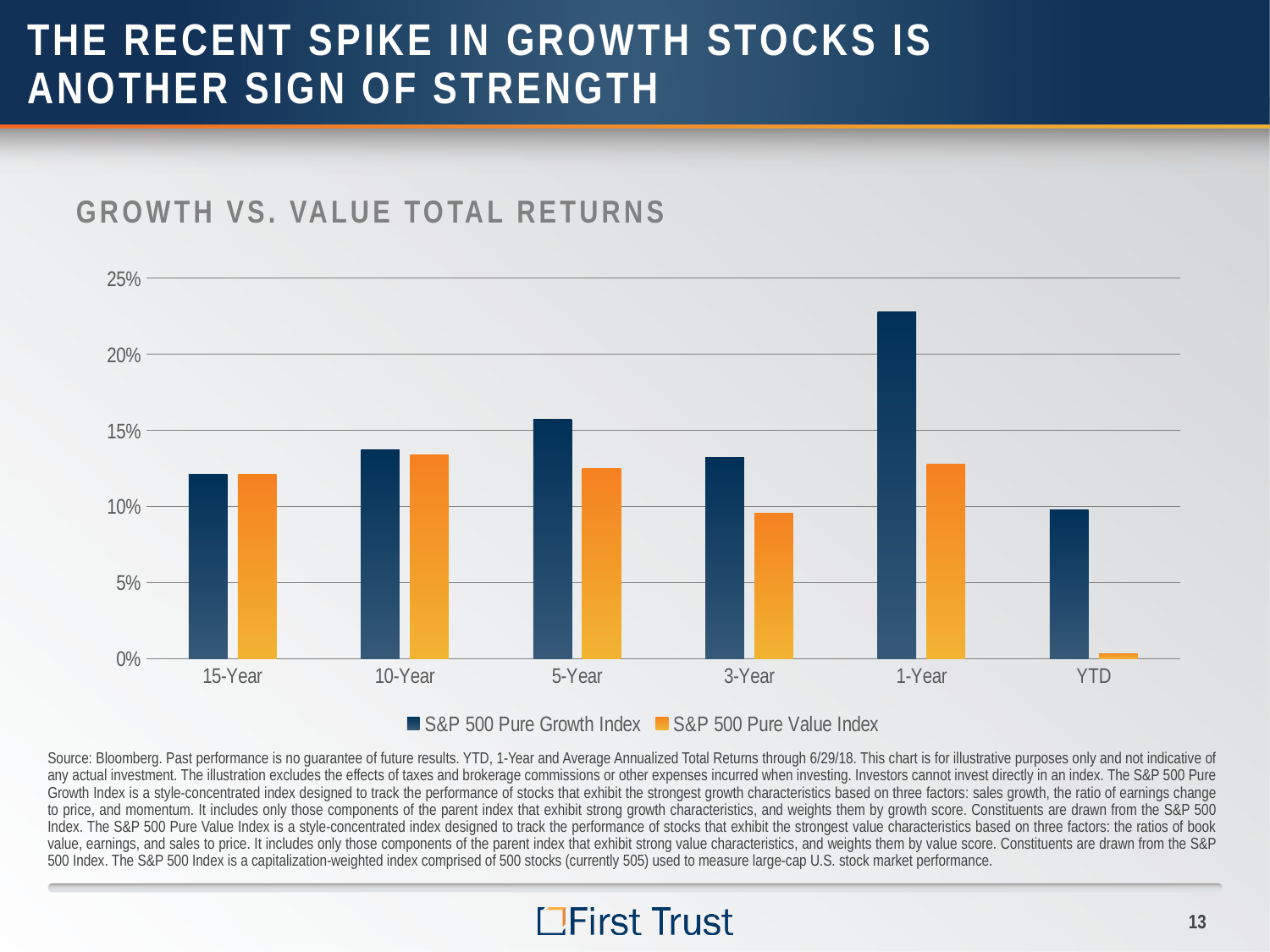
Which period has the lowest value for the S&P 500 Pure Growth Index? YTD What is the title of the chart? GROWTH VS. VALUE TOTAL RETURNS Which period has the highest value for the S&P 500 Pure Growth Index? 1-Year How many time-period categories are shown on the x axis? 6 How many series does the legend list? 2 Is the 1-Year value for the S&P 500 Pure Growth Index greater or less than 20%? greater Is the 3-Year value for the S&P 500 Pure Value Index greater or less than 10%? less Which period has the lowest value for the S&P 500 Pure Value Index? YTD For the 1-Year period, which is larger: the S&P 500 Pure Growth Index or the S&P 500 Pure Value Index? S&P 500 Pure Growth Index What type of chart is shown on the slide? bar chart Is the 5-Year value for the S&P 500 Pure Growth Index greater or less than 15%? greater